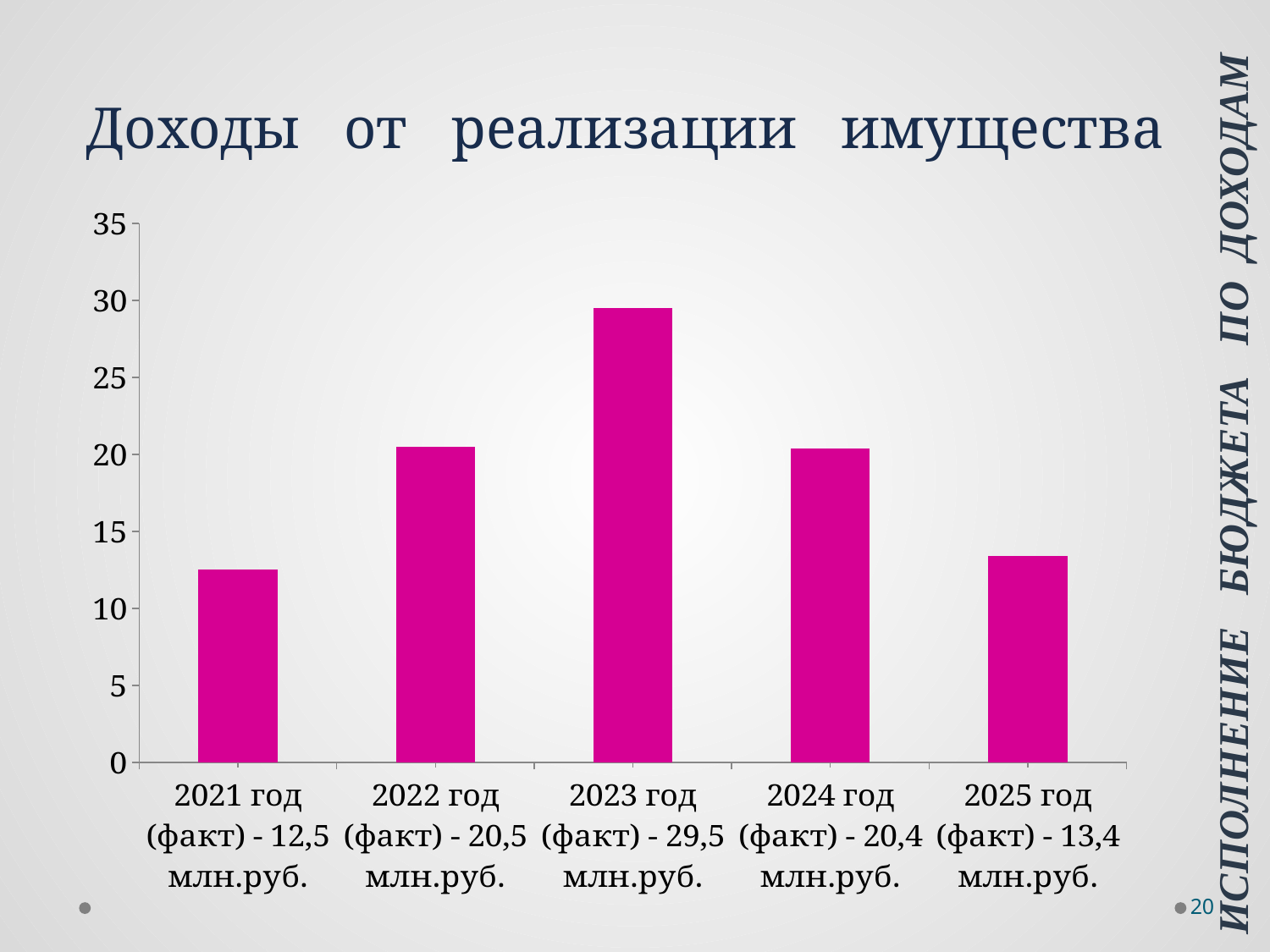
What is the title of the chart? Доходы от реализации имущества What is the value for 2025 год (факт)? 13,4 млн.руб. Which is larger, the value for 2024 год or the value for 2025 год? 2024 год Which year has the highest value? 2023 год How many years are shown on the x axis? 5 Is the value for 2023 год greater or less than 25? greater What is the value for 2023 год (факт)? 29,5 млн.руб. What is the difference between the values for 2022 год and 2025 год? 7,1 млн.руб. Which year has the lowest value? 2021 год What is the value for 2021 год (факт)? 12,5 млн.руб. What type of chart is shown on the slide? bar chart What is the difference between the values for 2023 год and 2021 год? 17 млн.руб.